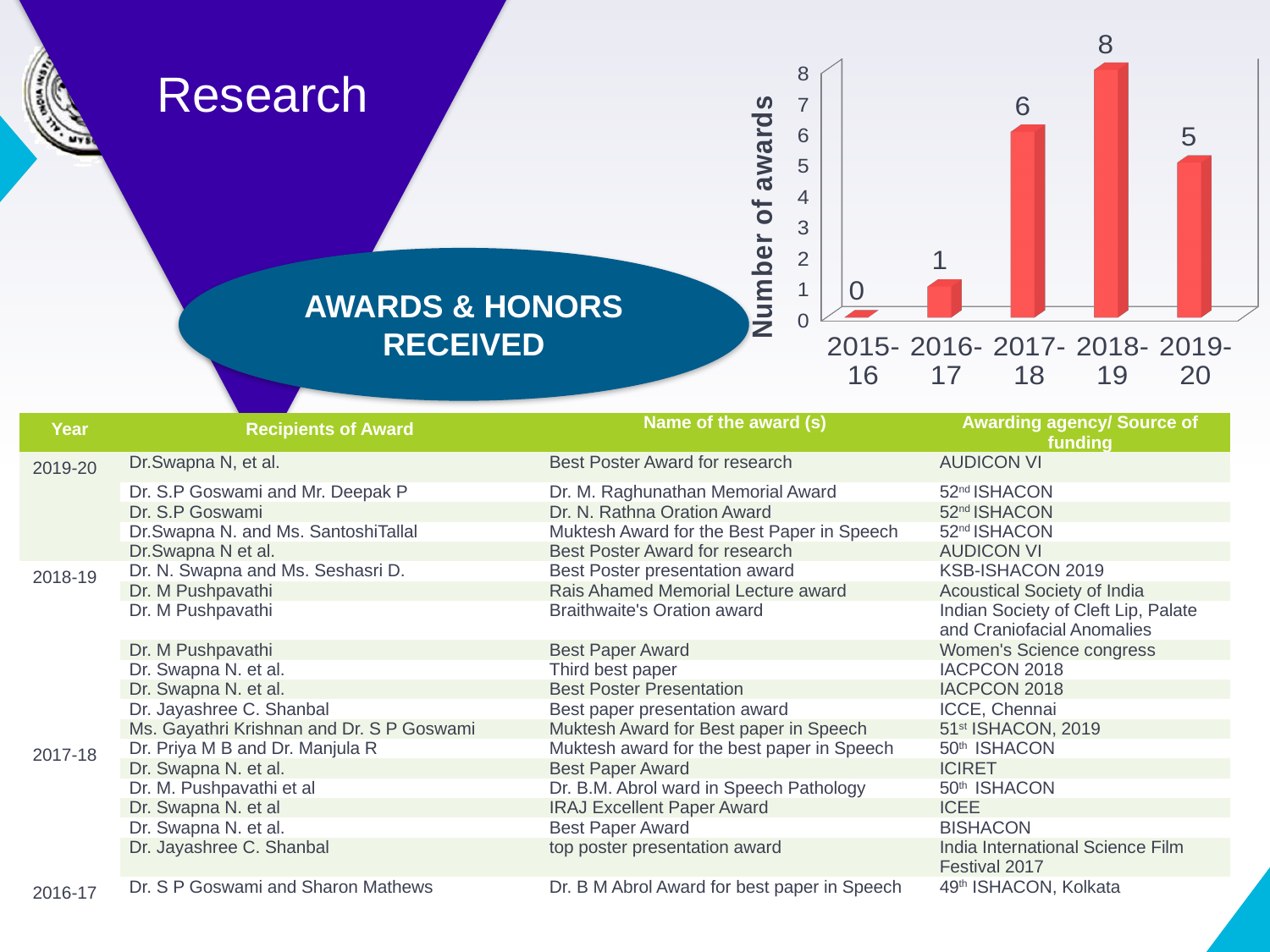
What kind of chart is shown on the slide? bar chart Which year has more awards, 2017-18 or 2019-20? 2017-18 What is the total number of awards across all five years shown in the chart? 20 Which year has the highest number of awards? 2018-19 What is the label of the vertical axis of the chart? Number of awards What is the number of awards for 2019-20? 5 How many years are shown on the x axis of the chart? 5 What is the difference in number of awards between 2018-19 and 2017-18? 2 What is the number of awards for 2018-19? 8 What is the number of awards for 2016-17? 1 Which year has the lowest number of awards? 2015-16 What is the number of awards for 2015-16? 0